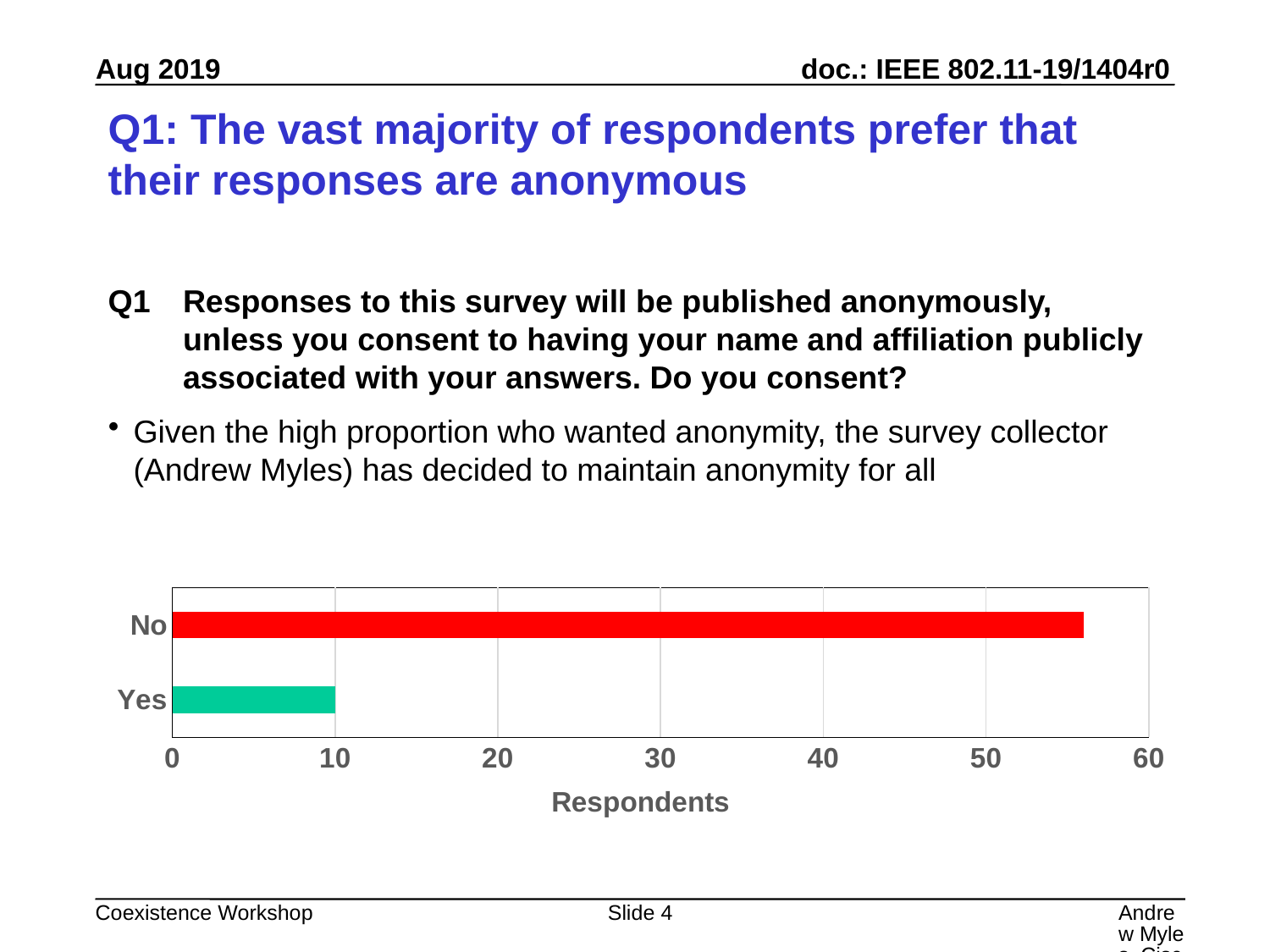
What colour is the bar for No? red Is the value for Yes greater or less than 20? less Is the value for No greater or less than 60? less Which category has the highest number of respondents? No How many categories does the chart show? 2 Is the value for No greater or less than 50? greater What is the maximum value shown on the horizontal axis? 60 What is the label of the horizontal axis? Respondents How many respondents answered Yes? 10 Which category has the lowest number of respondents? Yes Which is larger, the value for No or the value for Yes? No What kind of chart is shown on the slide? bar chart